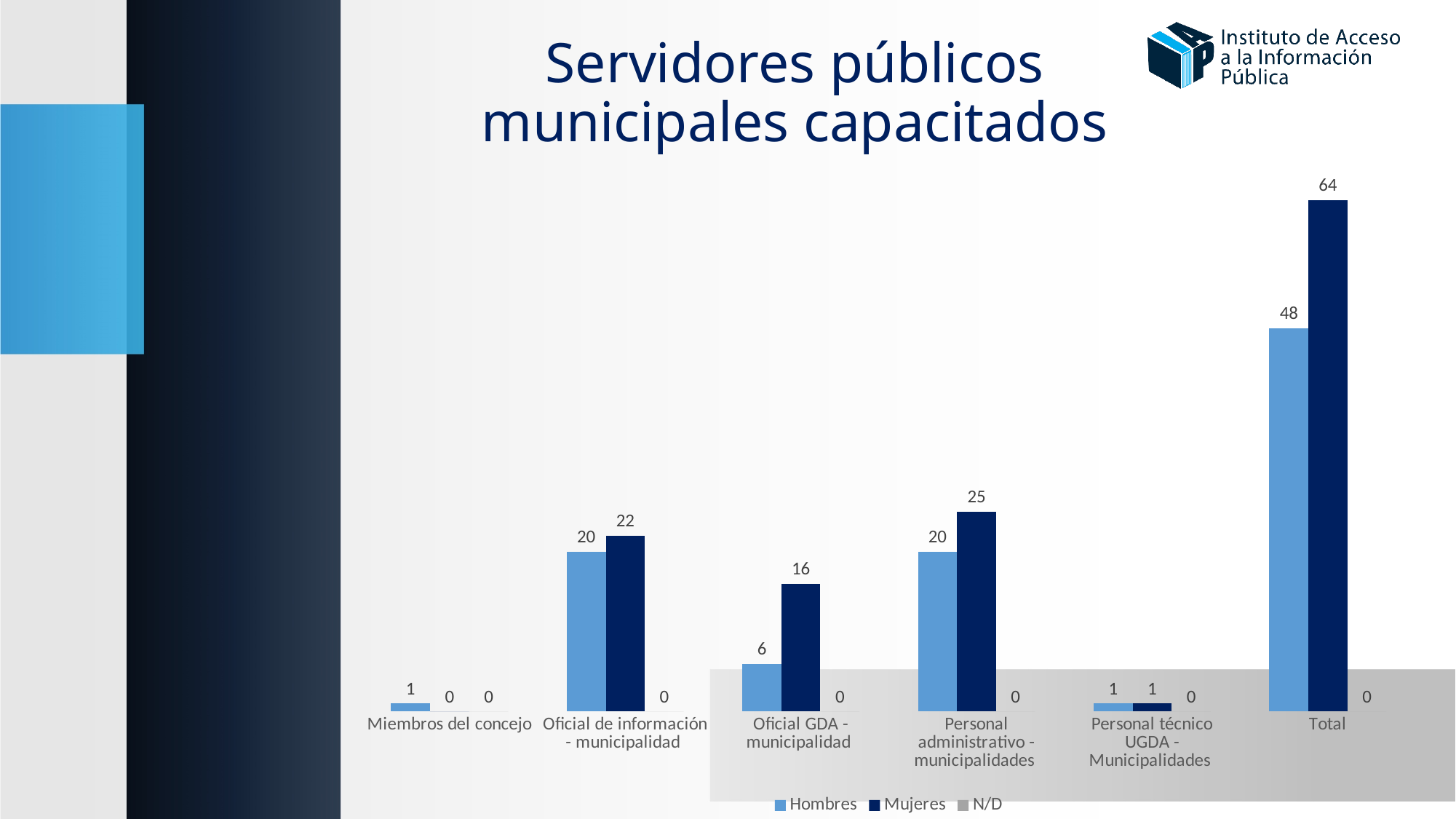
What is the value for Mujeres in the Total category? 64 Which category has the lowest Hombres value? Miembros del concejo and Personal técnico UGDA - Municipalidades (both 1) How many categories are shown on the x axis? 6 What is the difference between the Mujeres and Hombres values in the Total category? 16 What is the value for Hombres in the Personal administrativo - municipalidades category? 20 What is the title of the chart? Servidores públicos municipales capacitados How many series does the legend list? 3 What is the value for Mujeres in the Oficial GDA - municipalidad category? 16 Which is larger in the Oficial de información - municipalidad category, Hombres or Mujeres? Mujeres Excluding Total, which category has the highest Mujeres value? Personal administrativo - municipalidades What is the value for N/D in the Oficial de información - municipalidad category? 0 What kind of chart is shown on the slide? Bar chart